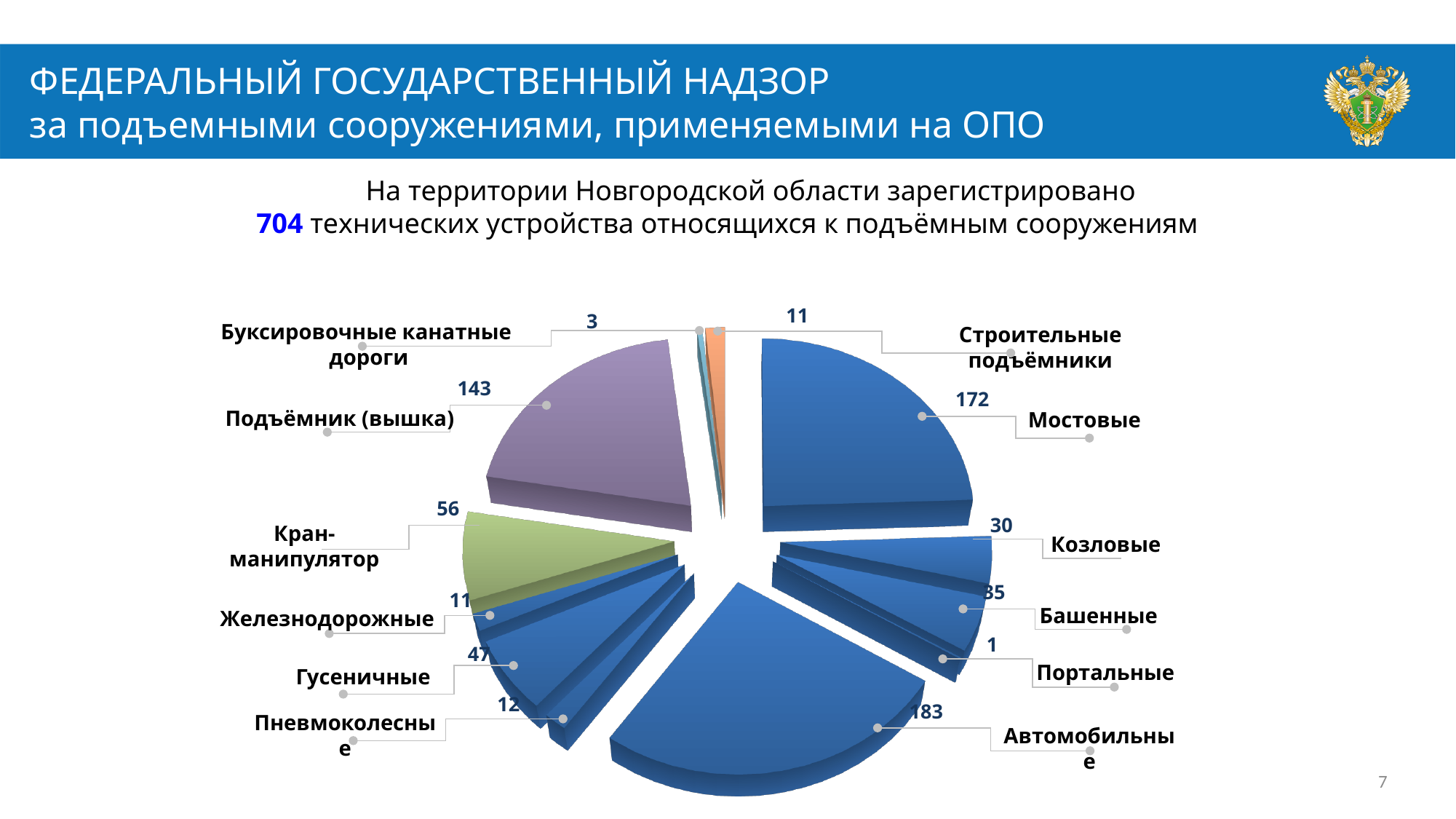
What is the difference between the values for Козловые and Пневмоколесные? 18 What is the total number of technical devices stated on the slide for the Novgorod region? 704 Which category has the smallest slice in the pie chart? Портальные Which category has the largest slice in the pie chart? Автомобильные What type of chart is shown on the slide? pie chart What is the difference between the values for Автомобильные and Мостовые? 11 Which is larger, the value for Гусеничные or the value for Башенные? Гусеничные What is the value for Мостовые in the pie chart? 172 How many categories (slices) does the pie chart have? 12 What is the value for Кран-манипулятор in the pie chart? 56 What is the value for Подъёмник (вышка) in the pie chart? 143 What is the value for Буксировочные канатные дороги in the pie chart? 3